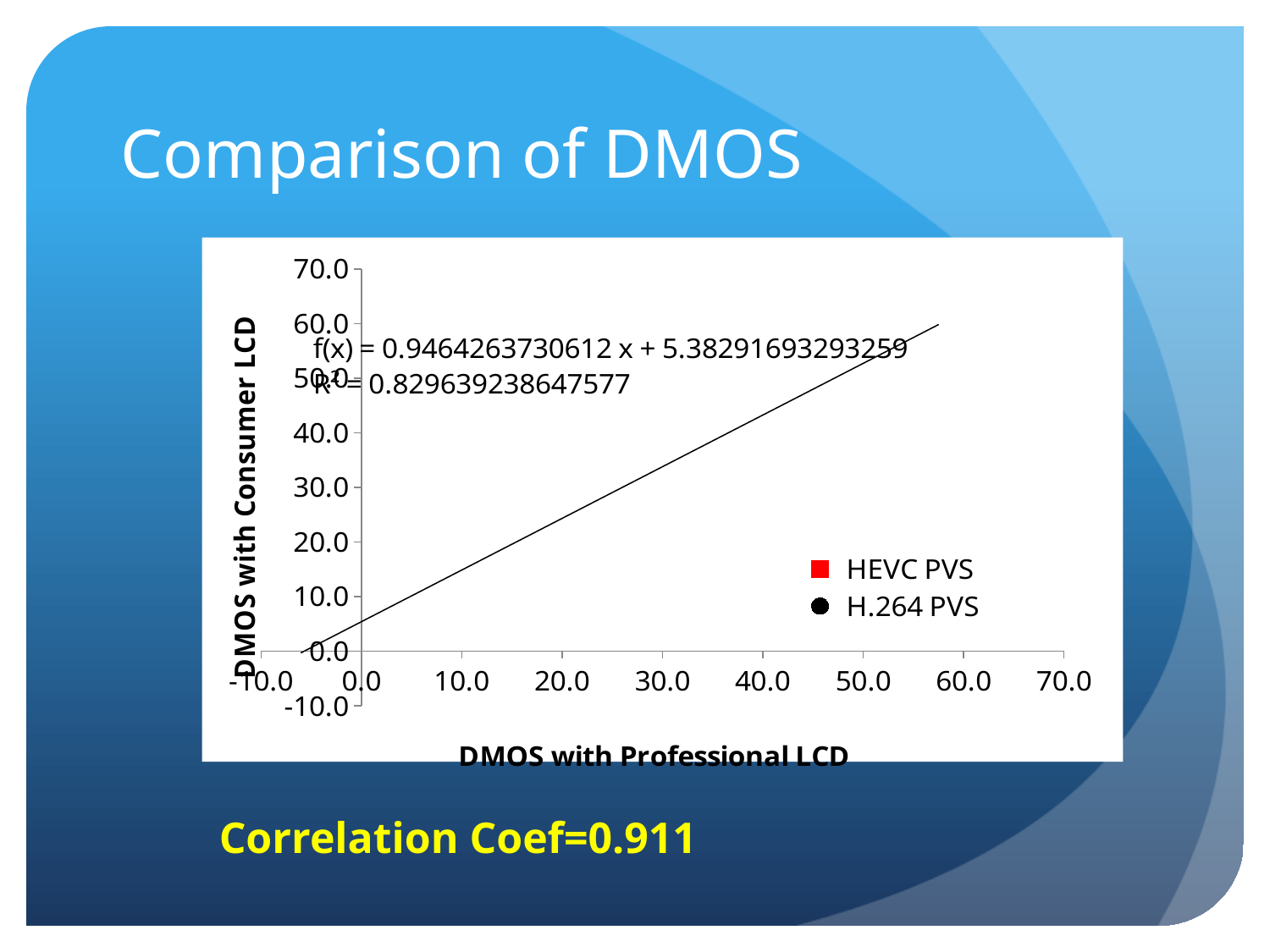
What is the intercept of the trendline equation printed on the chart? 5.38291693293259 What are the two series named in the chart legend? HEVC PVS and H.264 PVS Does the trendline on the chart rise or fall as the x-axis value increases? Rise What is the maximum value shown on the chart's y axis? 70.0 What colour is the legend marker for HEVC PVS? Red How many series does the chart legend list? 2 What is the slope of the trendline equation printed on the chart? 0.9464263730612 What correlation coefficient is stated below the chart? 0.911 What is the title of the chart's x axis? DMOS with Professional LCD What R² value is printed on the chart? 0.829639238647577 What is the title of the chart's y axis? DMOS with Consumer LCD What kind of chart is shown on the slide? Scatter chart